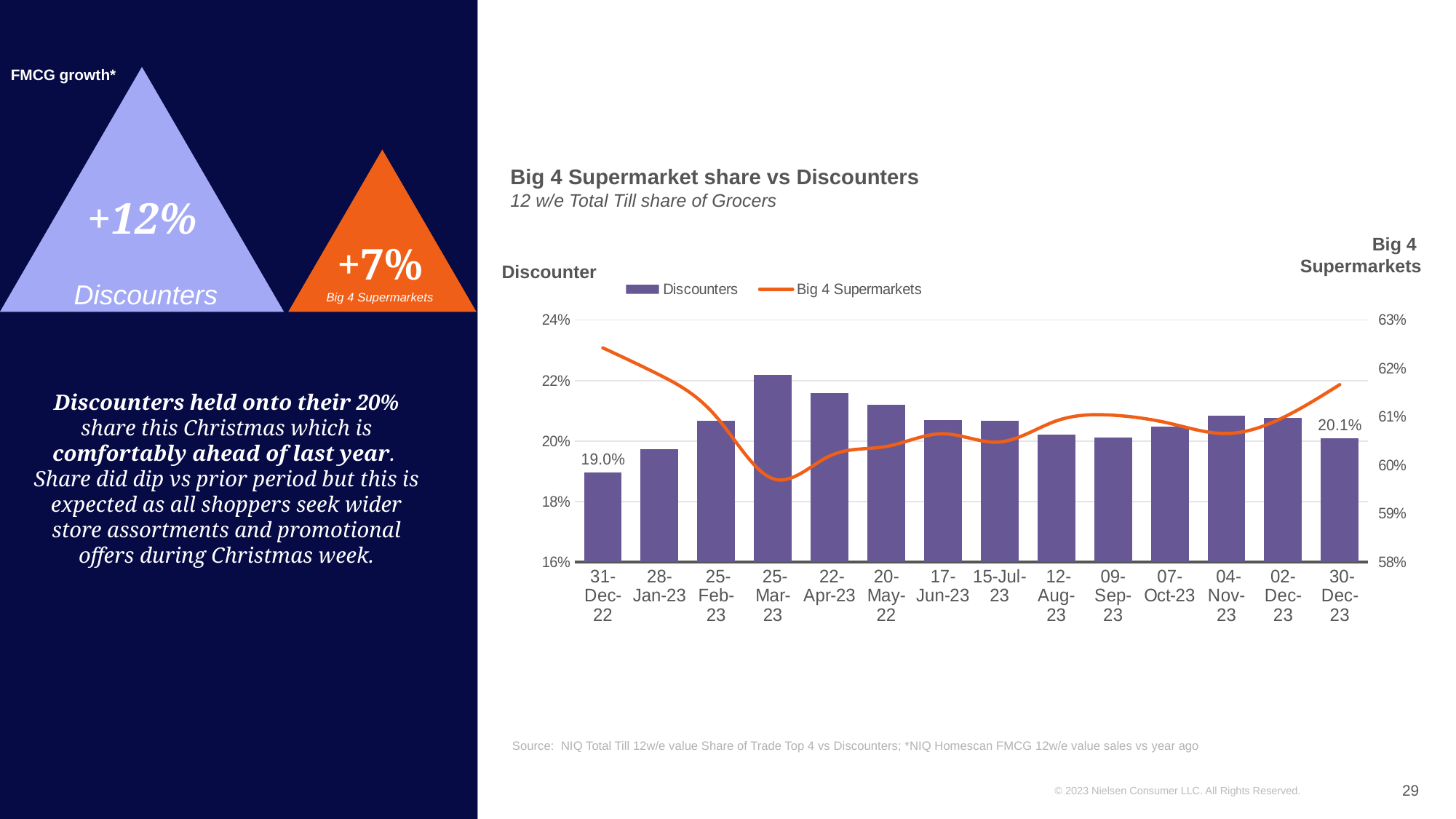
What is the Discounters share for 31-Dec-22? 19.0% By how many percentage points is the Discounters share for 30-Dec-23 higher than for 31-Dec-22? 1.1 percentage points How many periods are shown on the x axis? 14 At which period does the Big 4 Supermarkets line reach its lowest point? 25-Mar-23 Which period has the highest Discounters bar? 25-Mar-23 How many series does the legend list? 2 What is the Discounters share for 30-Dec-23? 20.1% What kind of chart is shown? A bar chart combined with a line chart Is the Discounters value for 28-Jan-23 greater or less than 20%? less Is the Discounters value for 22-Apr-23 greater or less than 22%? less Which is larger, the Discounters bar for 25-Mar-23 or for 22-Apr-23? 25-Mar-23 Which period has the lowest Discounters bar? 31-Dec-22